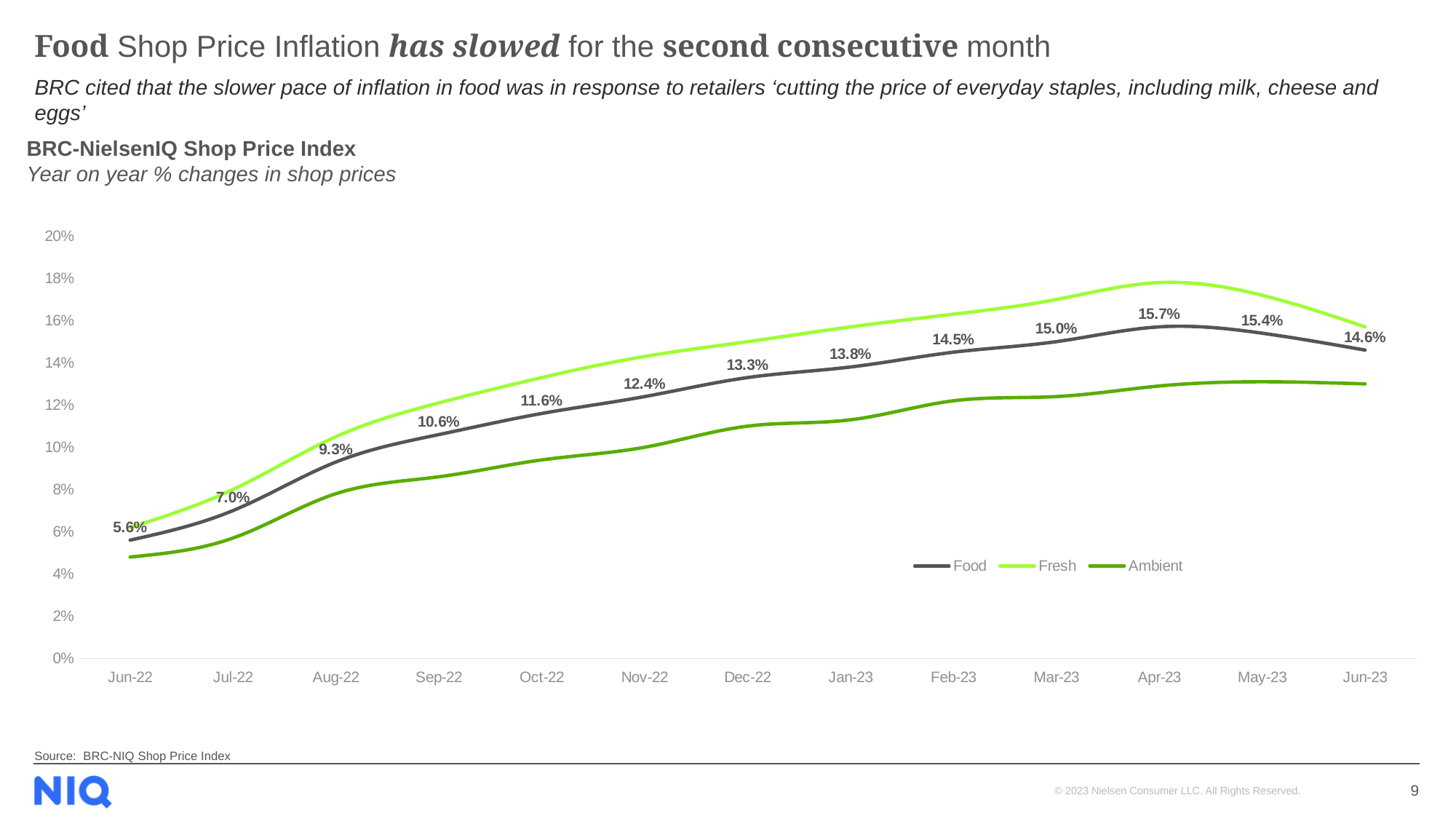
Which is larger, the Food value for Dec-22 or for Jan-23? Jan-23 Is the Fresh value for Apr-23 greater or less than 16%? greater Is the Ambient value for Jun-22 greater or less than 6%? less How many series does the legend list? 3 What is the difference between the Food values for Apr-23 and Jun-23? 1.1% What kind of chart is shown on the slide? Line chart In which month does the Food series reach its highest value? Apr-23 What is the Food value for Jun-23? 14.6% In which month is the Food series at its lowest value? Jun-22 How many months are shown on the x axis? 13 What is the Food value for Apr-23? 15.7% What is the Food value for Jun-22? 5.6%